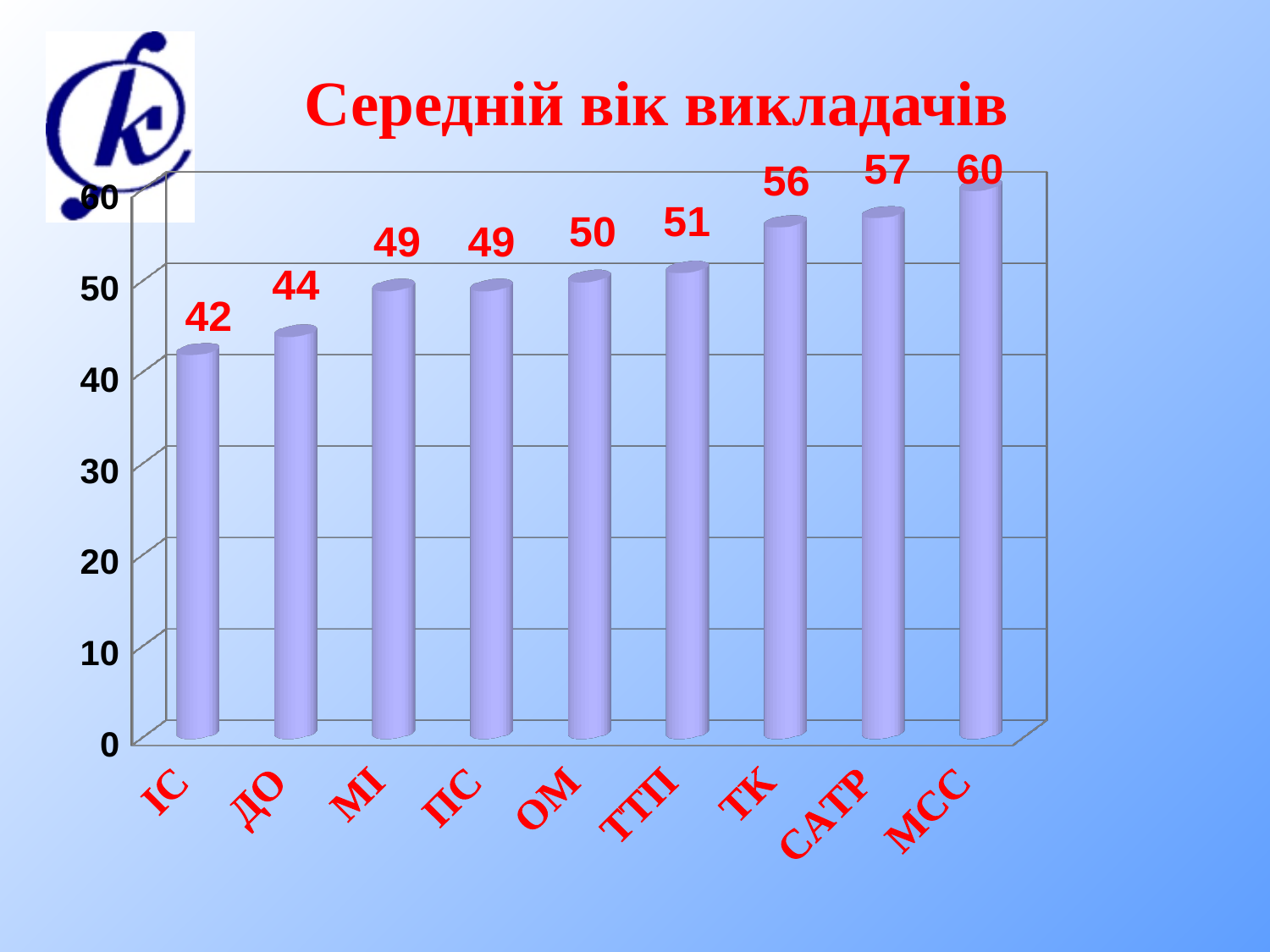
Which is larger, the value for ТТП or the value for МІ? ТТП How many categories are shown on the x axis? 9 Do the values rise or fall from left to right along the x axis? rise Which category has the highest value? МСС What is the value shown for ОМ? 50 What is the average age of teachers for ІС? 42 What is the value shown for САТР? 57 What is the difference between the values for ТК and ДО? 12 Which category has the lowest value? ІС What kind of chart is shown on the slide? bar chart What is the difference between the values for МСС and ІС? 18 What is the title of the chart? Середній вік викладачів